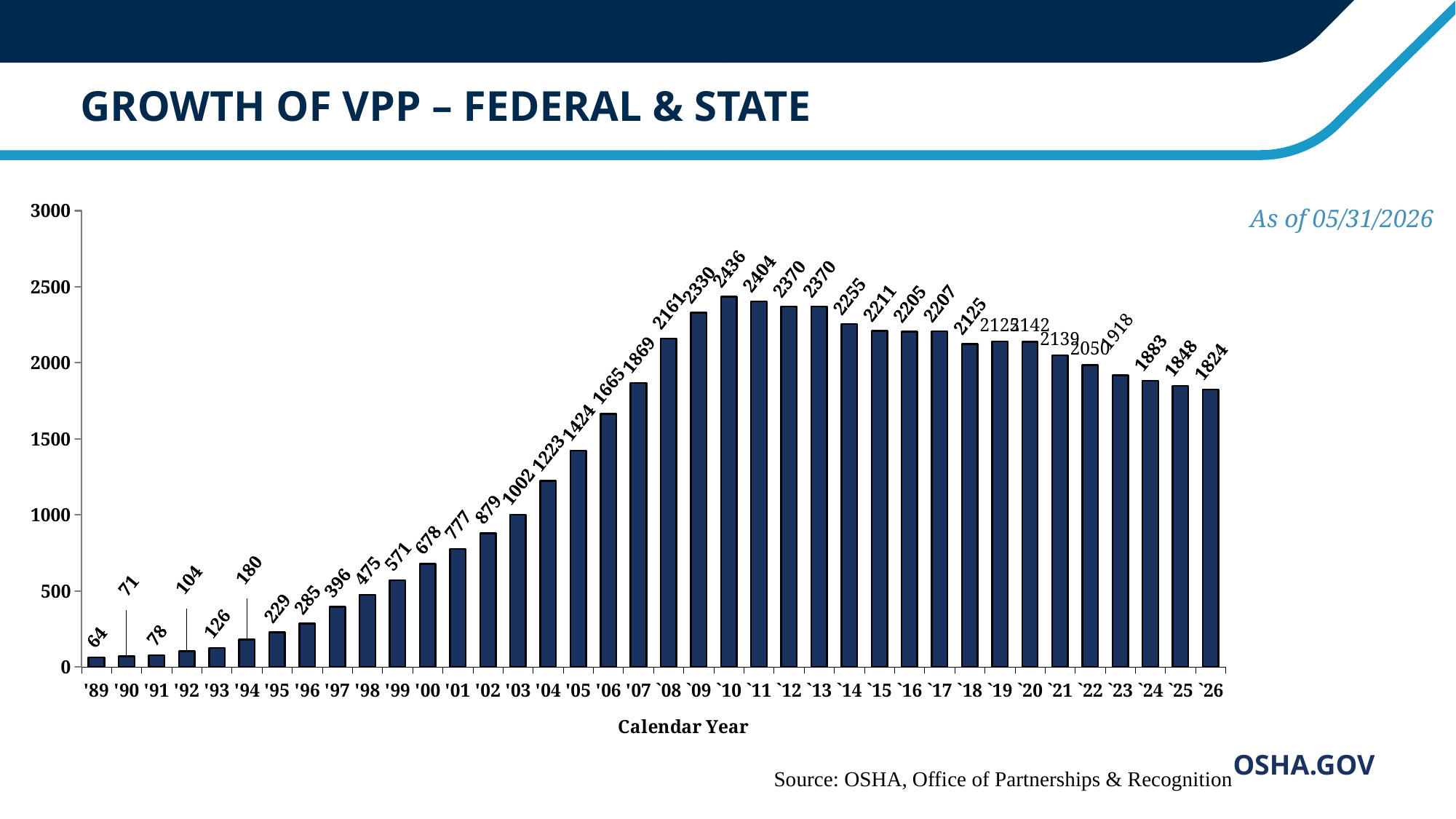
What is the value for '89? 64 Which is larger, the value for '13 or the value for '14? '13 What is the difference between the values for '10 and '26? 612 Is the value for '05 greater or less than 1500? less How many years are shown on the x axis? 38 What is the difference between the values for '09 and '08? 169 What is the value for '10? 2436 What is the value for '26? 1824 Do the values rise or fall from '89 to '10? rise Which year has the highest value? '10 Which year has the lowest value? '89 What kind of chart is this? bar chart